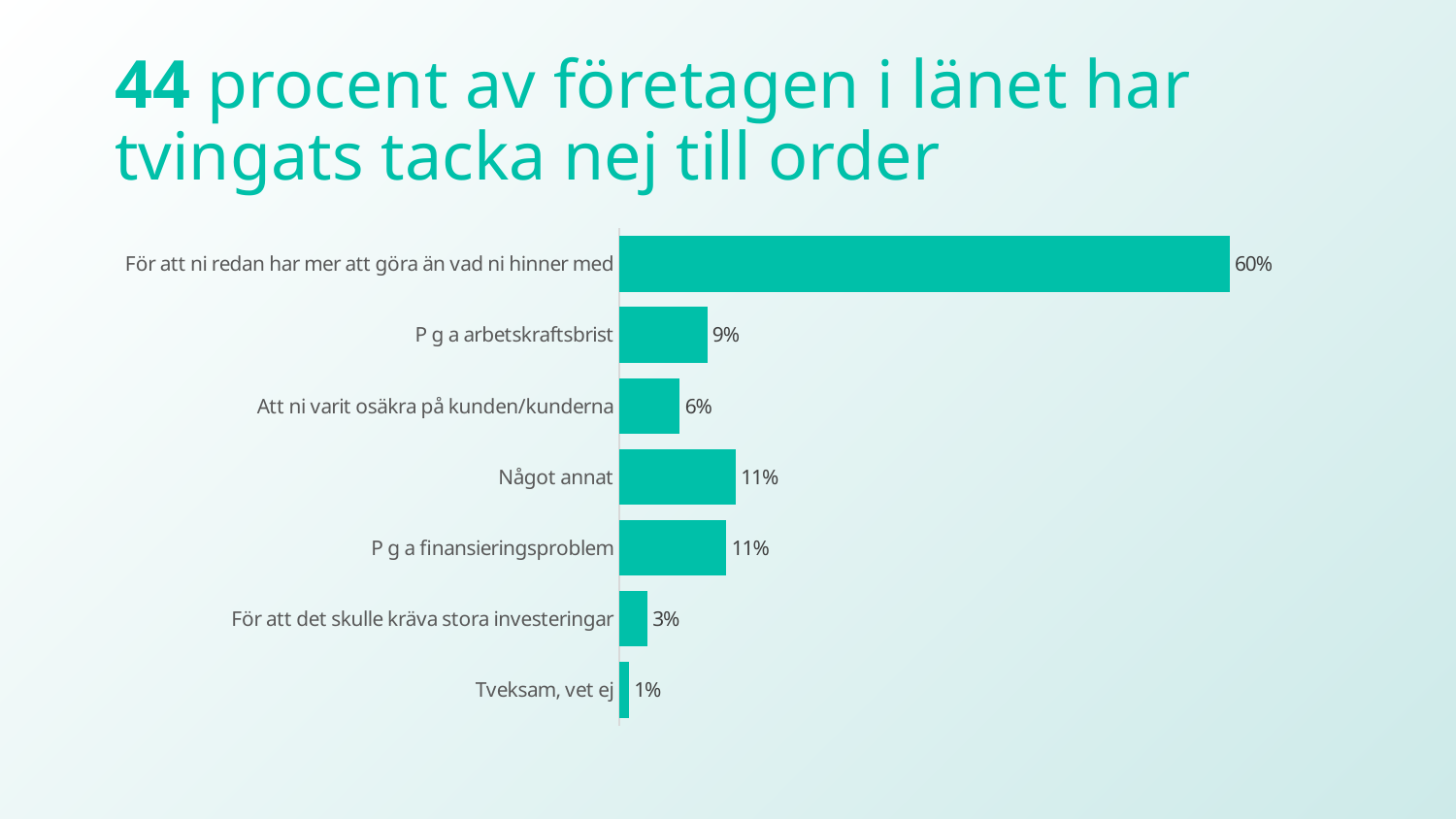
What is the difference between the values for "Något annat" and "För att det skulle kräva stora investeringar"? 8% Which category has the lowest value? Tveksam, vet ej What is the value for "P g a arbetskraftsbrist"? 9% What kind of chart is shown on the slide? Bar chart What colour are the bars in the chart? Teal How many categories are shown in the chart? 7 What is the value for "Att ni varit osäkra på kunden/kunderna"? 6% Which is larger, the value for "P g a arbetskraftsbrist" or the value for "Att ni varit osäkra på kunden/kunderna"? P g a arbetskraftsbrist What is the value for "Tveksam, vet ej"? 1% Which category has the highest value? För att ni redan har mer att göra än vad ni hinner med What is the difference between the values for "För att ni redan har mer att göra än vad ni hinner med" and "P g a arbetskraftsbrist"? 51% What is the value for "För att det skulle kräva stora investeringar"? 3%